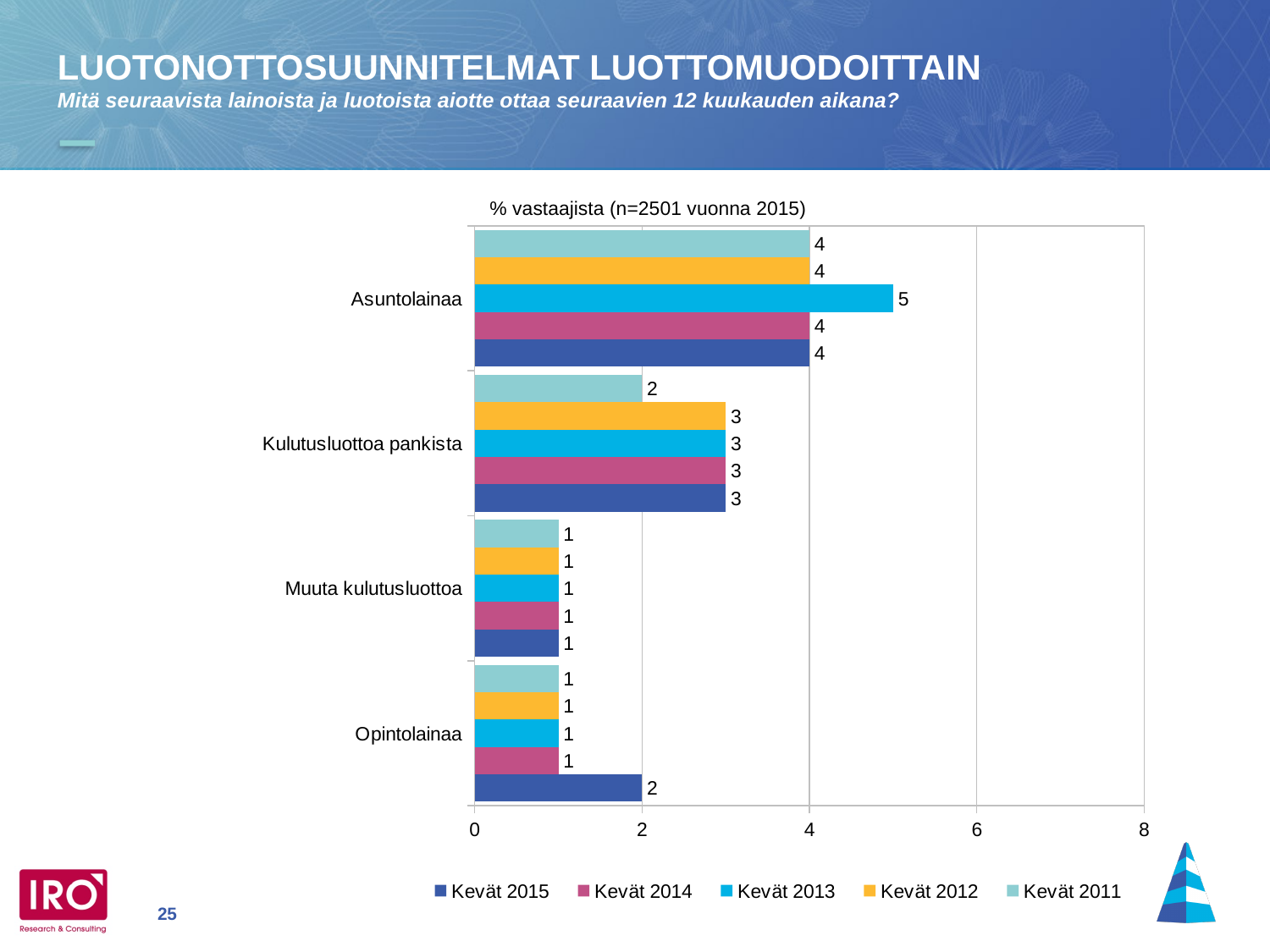
What is the value for Muuta kulutusluottoa in the Kevät 2014 series? 1 What is the value for Opintolainaa in the Kevät 2015 series? 2 How many series does the legend list? 5 What is the difference between the Kevät 2013 value for Asuntolainaa and the Kevät 2013 value for Kulutusluottoa pankista? 2 Which is larger: the Kevät 2015 value for Opintolainaa or the Kevät 2014 value for Opintolainaa? Kevät 2015 What kind of chart is shown on the slide? Bar chart Which category has the highest value in the Kevät 2015 series? Asuntolainaa What is the value for Asuntolainaa in the Kevät 2013 series? 5 How many categories are shown on the chart? 4 What is the value for Kulutusluottoa pankista in the Kevät 2011 series? 2 What is the title shown above the chart? % vastaajista (n=2501 vuonna 2015)